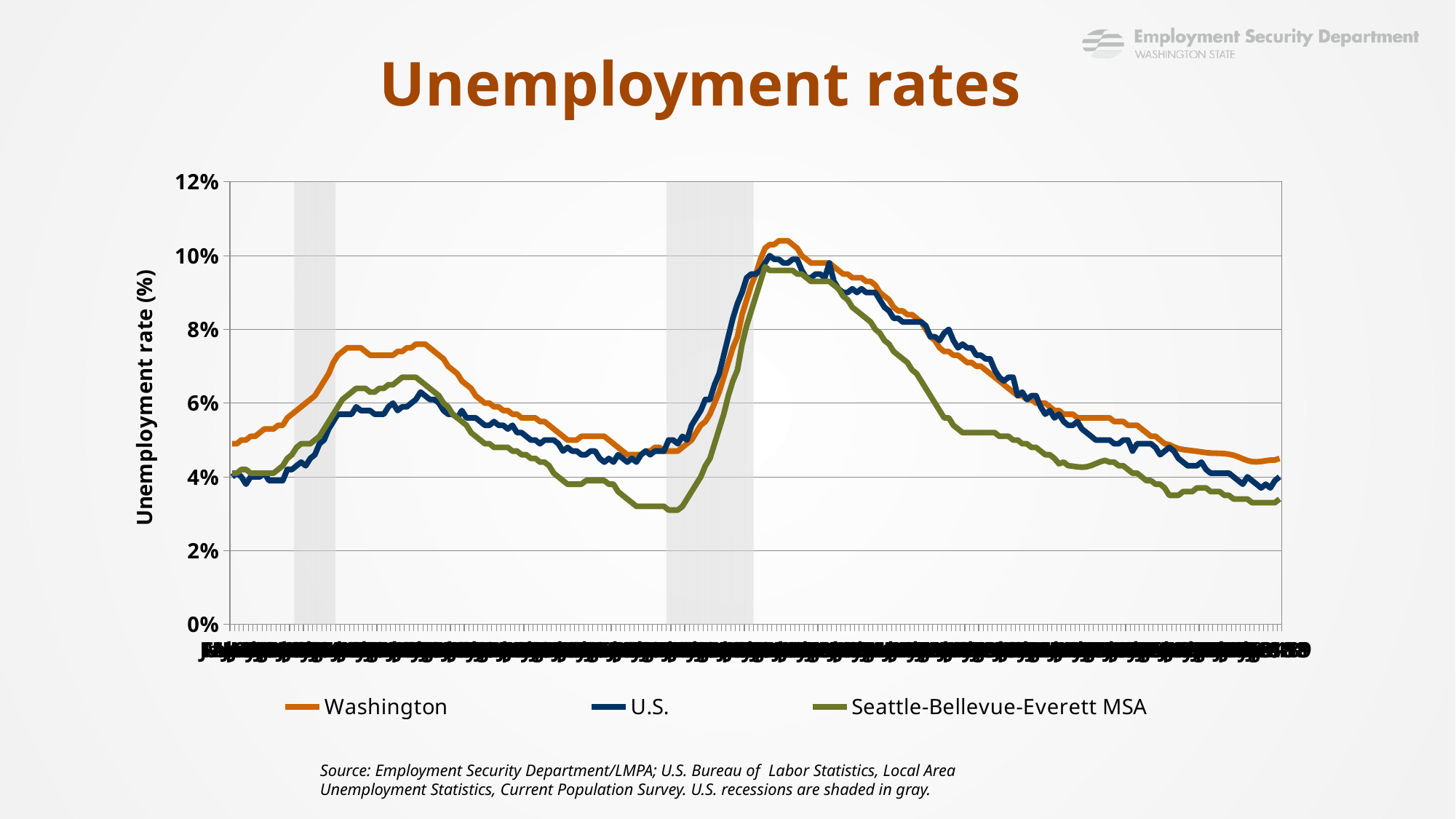
What kind of chart is shown on the slide? line chart What is the label on the vertical axis? Unemployment rate (%) What is the highest value shown on the vertical axis? 12% Which series reaches the highest peak on the chart? Washington After the peak in the second shaded recession period, do the unemployment rates rise or fall toward the right end of the chart? fall What is the title of the chart? Unemployment rates At the right-hand end of the chart, which is higher, the Washington series or the U.S. series? Washington How many series does the legend list? 3 Which series is lowest at the right-hand end of the chart? Seattle-Bellevue-Everett MSA Is the highest value of the Seattle-Bellevue-Everett MSA series greater or less than 10%? less Is the lowest value of the Seattle-Bellevue-Everett MSA series greater or less than 4%? less Is the highest value of the Washington series greater or less than 10%? greater